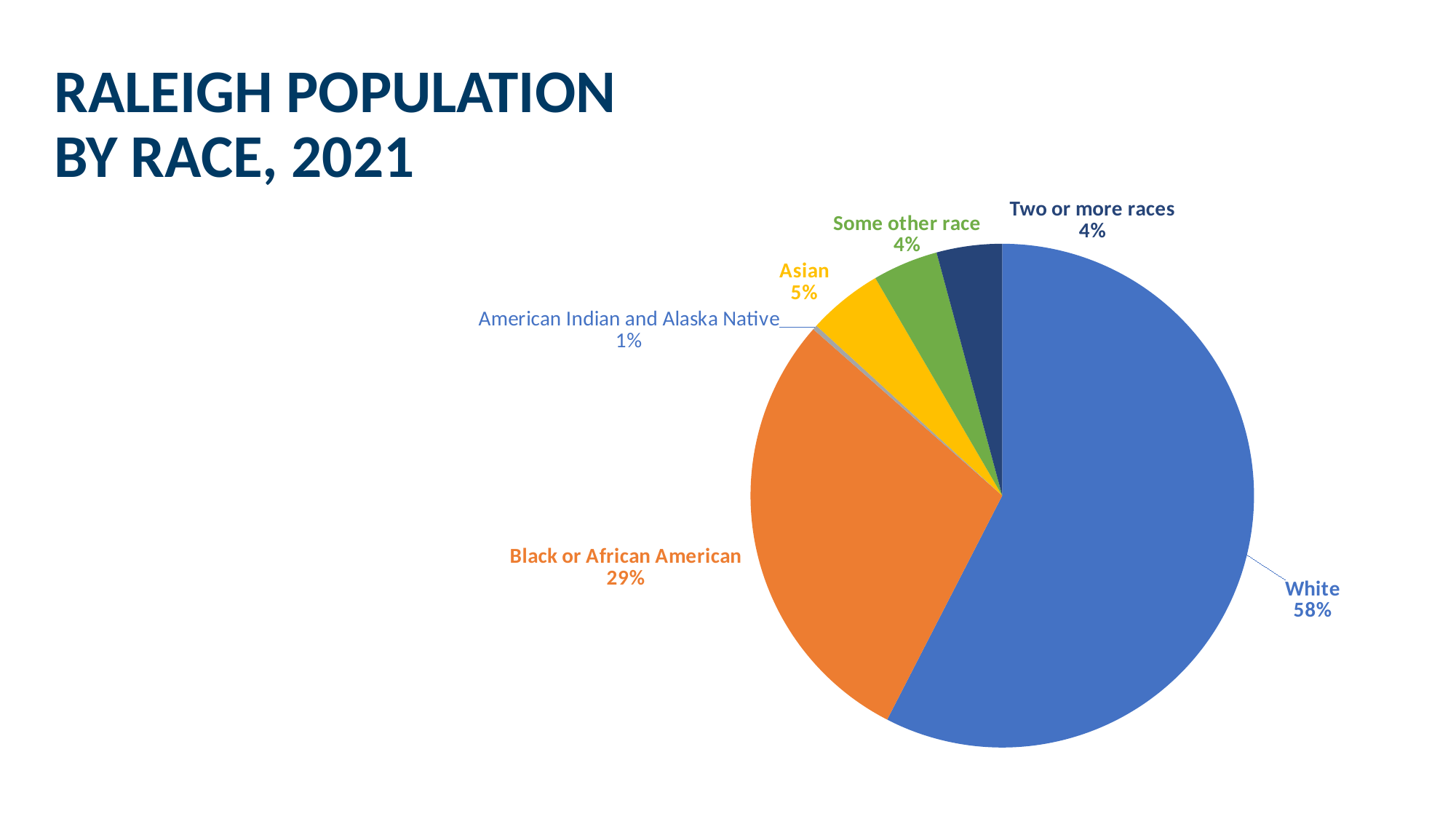
Which is larger, the share for Asian or the share for Some other race? Asian What kind of chart is shown on the slide? Pie chart Which race group has the largest share of the Raleigh population? White What share of the Raleigh population is Asian? 5% What share of the Raleigh population is Black or African American? 29% What share of the Raleigh population is American Indian and Alaska Native? 1% What colour is the slice for Black or African American? Orange What share of the Raleigh population is White? 58% How many race categories are shown in the pie chart? 6 Which race group has the smallest share of the Raleigh population? American Indian and Alaska Native What is the difference in percentage points between the White and Black or African American shares? 29 What is the title of the slide? RALEIGH POPULATION BY RACE, 2021